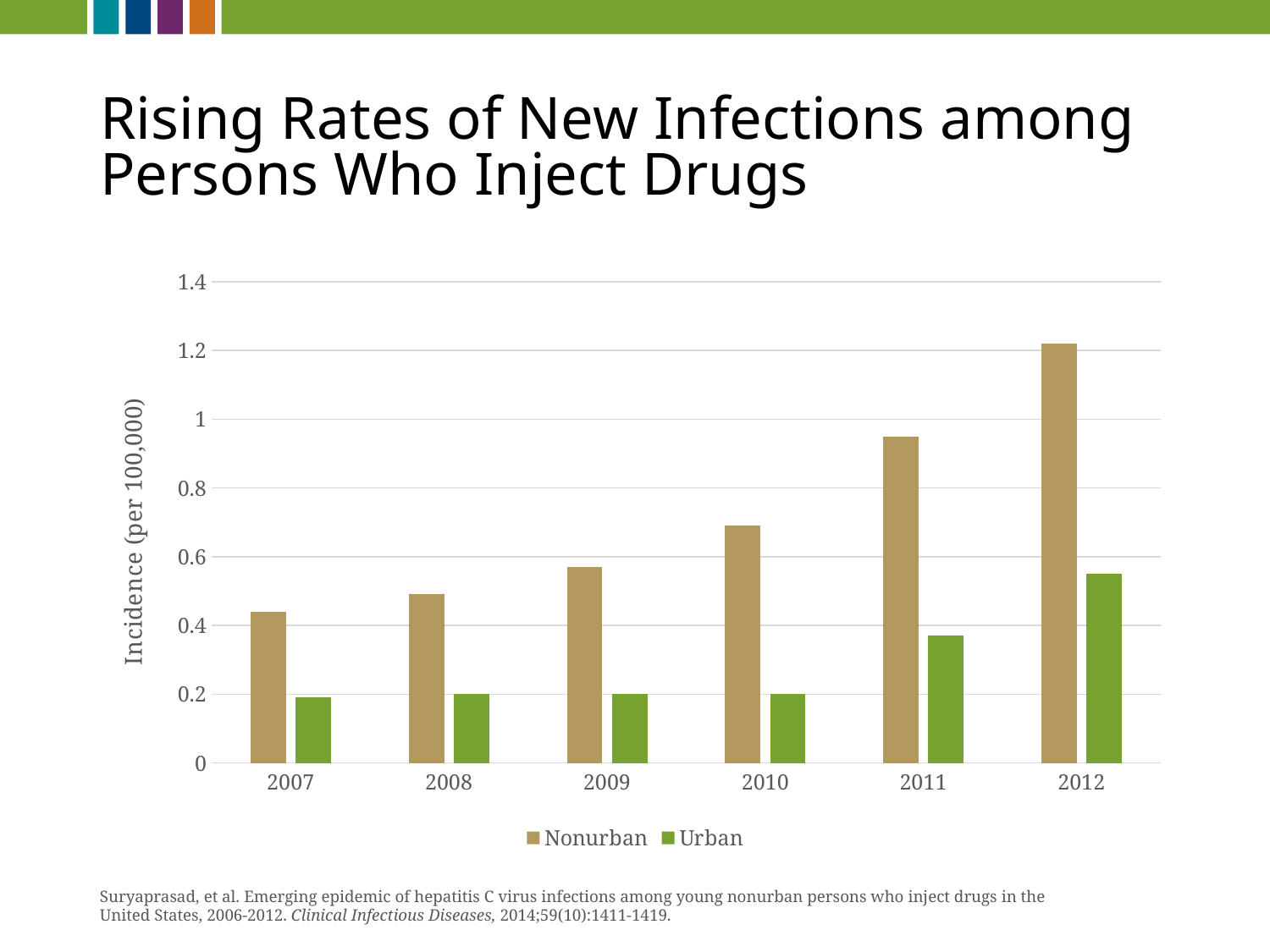
What is the label on the y axis? Incidence (per 100,000) Is the Nonurban value for 2012 greater or less than 1? greater Which year has the highest Nonurban incidence? 2012 Is the Nonurban value for 2007 greater or less than 0.6? less In 2012, which series has the larger value, Nonurban or Urban? Nonurban Is the Urban value for 2012 greater or less than 0.4? greater Does the Nonurban incidence rise or fall from 2007 to 2012? rise How many series does the legend list? 2 How many years are shown on the x axis? 6 What kind of chart is shown on the slide? bar chart Which year has the highest Urban incidence? 2012